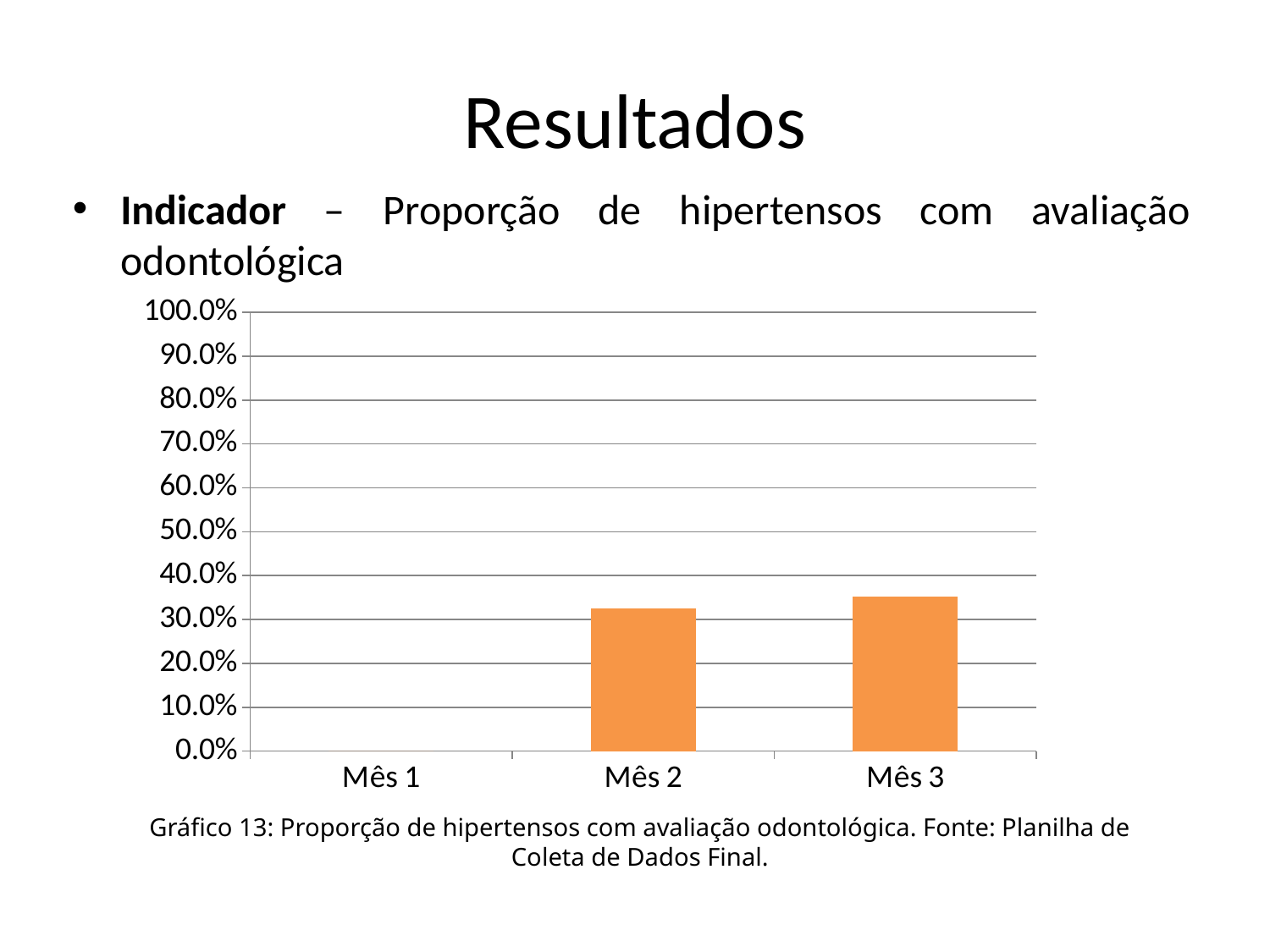
How many categories are shown on the x axis of the chart? 3 Is the value for Mês 2 greater or less than 40.0%? less Is the value for Mês 3 greater or less than 30.0%? greater Which month has the highest proportion of hypertensive patients with dental evaluation? Mês 3 Do the values rise or fall from Mês 1 to Mês 3? rise What is the highest value shown on the vertical axis of the chart? 100.0% Is the value for Mês 2 greater or less than 30.0%? greater Which is larger, the value for Mês 1 or the value for Mês 2? Mês 2 What kind of chart is shown on the slide? bar chart What is the number of the graph given in the caption below the chart? Gráfico 13 Which month has the lowest proportion of hypertensive patients with dental evaluation? Mês 1